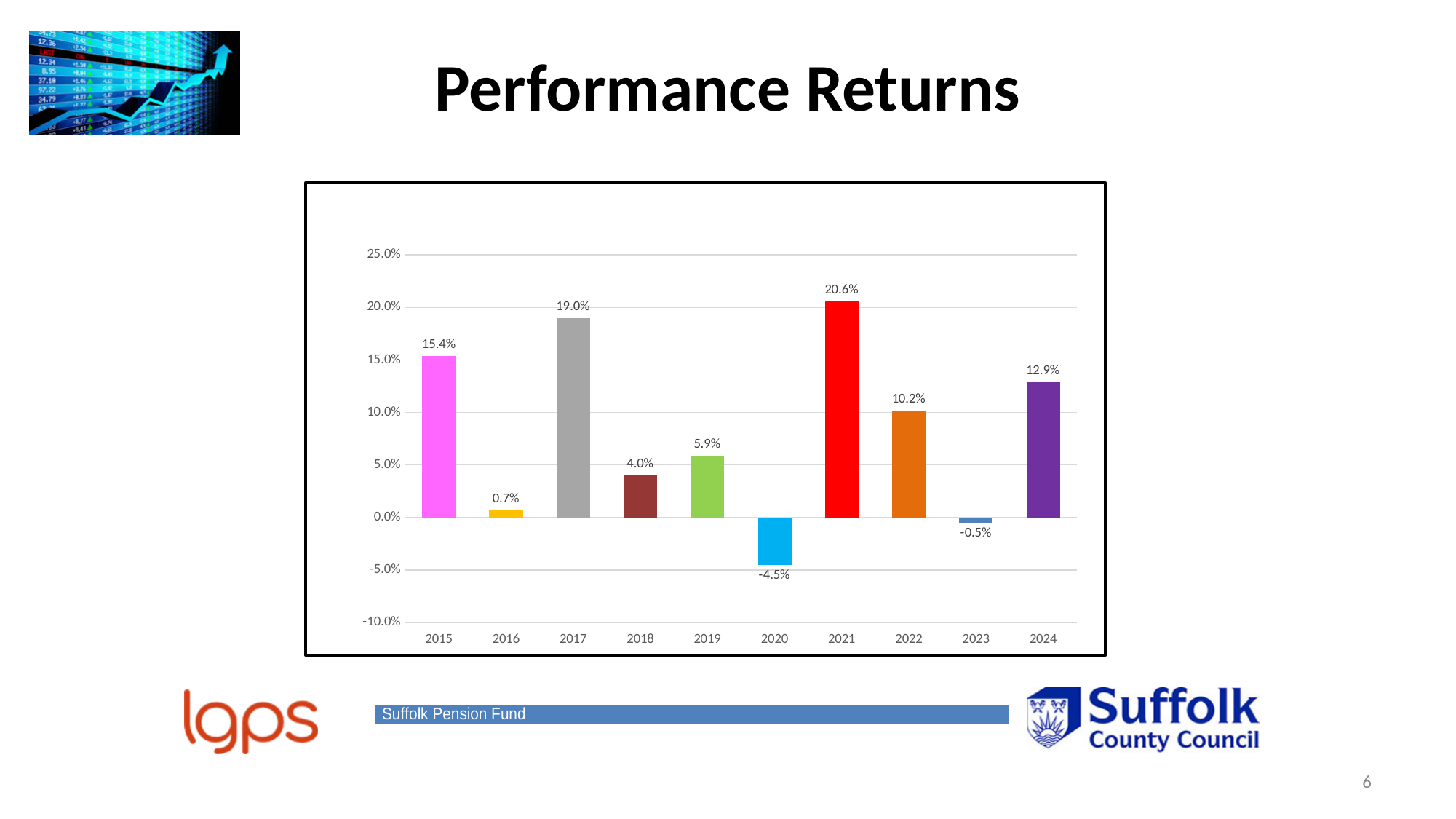
What is the performance return shown for 2020? -4.5% What is the performance return shown for 2021? 20.6% Which year has the larger return, 2019 or 2022? 2022 What is the performance return shown for 2024? 12.9% How many years show a negative return? 2 What is the title of the slide containing the chart? Performance Returns What kind of chart is shown on the slide? bar chart What is the difference between the 2017 return and the 2015 return? 3.6% Is the value for 2018 greater or less than 5.0%? less Which year has the lowest performance return? 2020 Which year has the highest performance return? 2021 How many years are shown on the x axis of the chart? 10